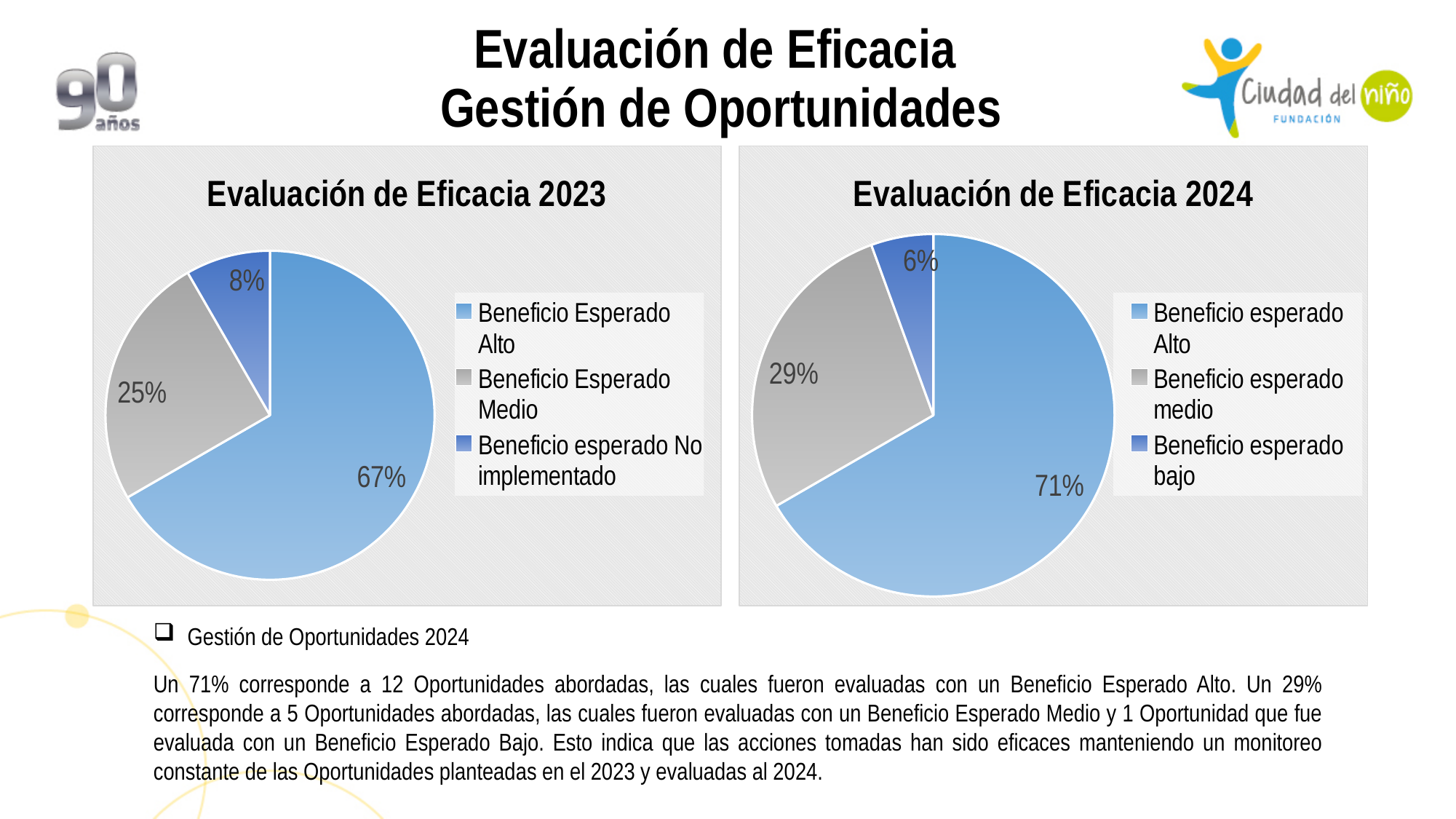
What type of chart is 'Evaluación de Eficacia 2023'? Pie chart In the 'Evaluación de Eficacia 2024' chart, what share does 'Beneficio esperado Alto' have? 71% Which is larger: the 'Beneficio esperado medio' share in the 2024 chart or the 'Beneficio Esperado Medio' share in the 2023 chart? The 2024 chart (29%) How many categories does the 'Evaluación de Eficacia 2024' chart show? 3 In the 'Evaluación de Eficacia 2024' chart, which category has the largest slice? Beneficio esperado Alto What is the title of the chart on the right side of the slide? Evaluación de Eficacia 2024 In the 'Evaluación de Eficacia 2023' chart, which category has the smallest slice? Beneficio esperado No implementado In the 'Evaluación de Eficacia 2023' chart, what share does 'Beneficio esperado No implementado' have? 8% In the 'Evaluación de Eficacia 2023' chart, what is the difference between the 'Beneficio Esperado Alto' and 'Beneficio Esperado Medio' shares? 42% In the 'Evaluación de Eficacia 2023' chart, what share does 'Beneficio Esperado Medio' have? 25% In the 'Evaluación de Eficacia 2023' chart, what share does 'Beneficio Esperado Alto' have? 67% In the 'Evaluación de Eficacia 2024' chart, what share does 'Beneficio esperado bajo' have? 6%